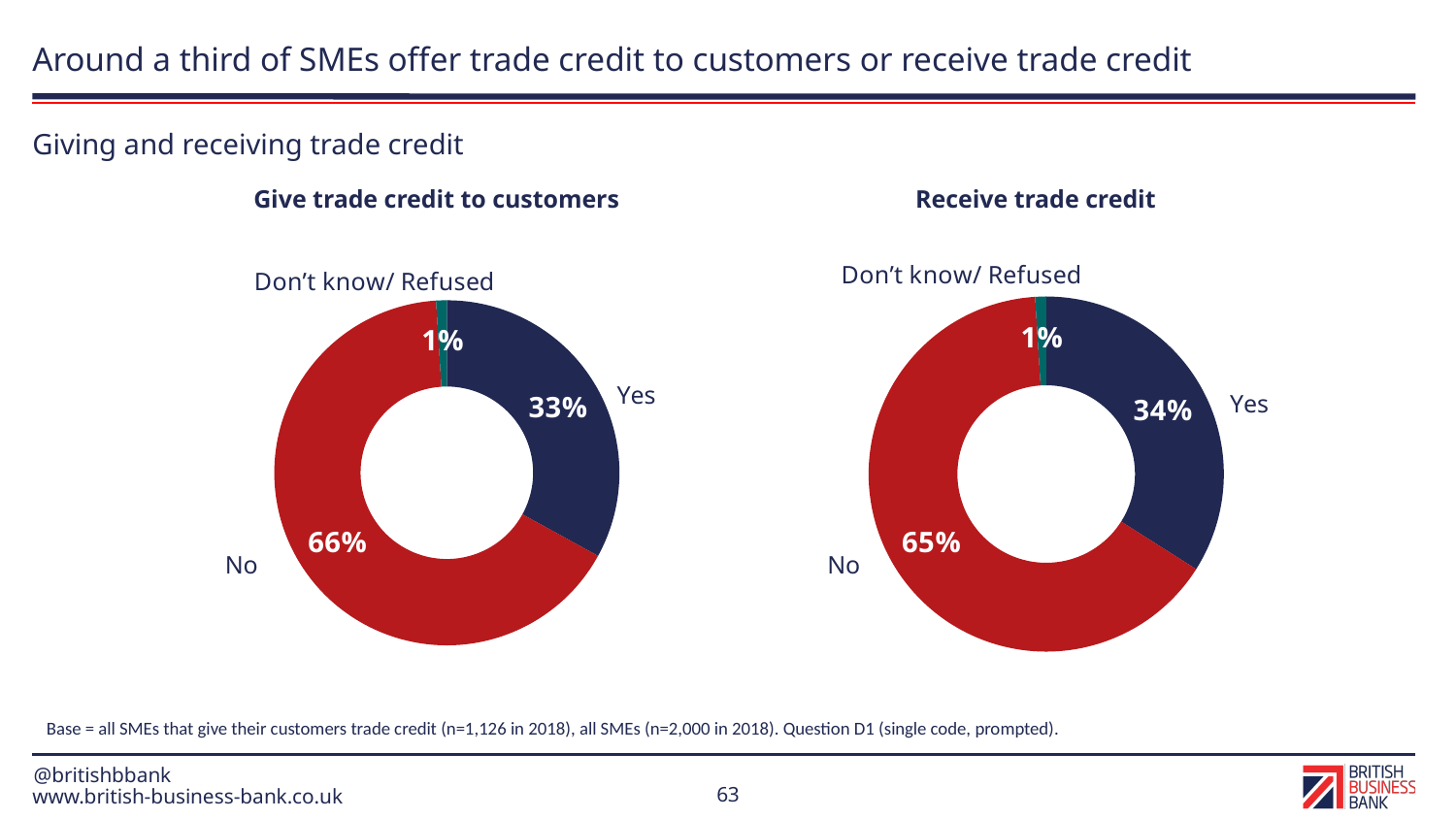
How many categories are shown in the 'Receive trade credit' chart? 3 In the 'Give trade credit to customers' chart, which category has the largest share? No In the 'Receive trade credit' chart, what percentage of SMEs answered Yes? 34% Which is larger: the Yes share in the 'Give trade credit to customers' chart or the Yes share in the 'Receive trade credit' chart? Receive trade credit What colour represents the No category in both charts? Red In the 'Give trade credit to customers' chart, what percentage of SMEs answered Yes? 33% In the 'Give trade credit to customers' chart, what percentage of SMEs answered No? 66% In the 'Receive trade credit' chart, what percentage is shown for Don't know/ Refused? 1% In the 'Receive trade credit' chart, what percentage of SMEs answered No? 65% What type of chart is used for 'Give trade credit to customers'? Pie chart (doughnut) In the 'Give trade credit to customers' chart, what is the difference between the No and Yes percentages? 33% In the 'Receive trade credit' chart, which category has the smallest share? Don't know/ Refused